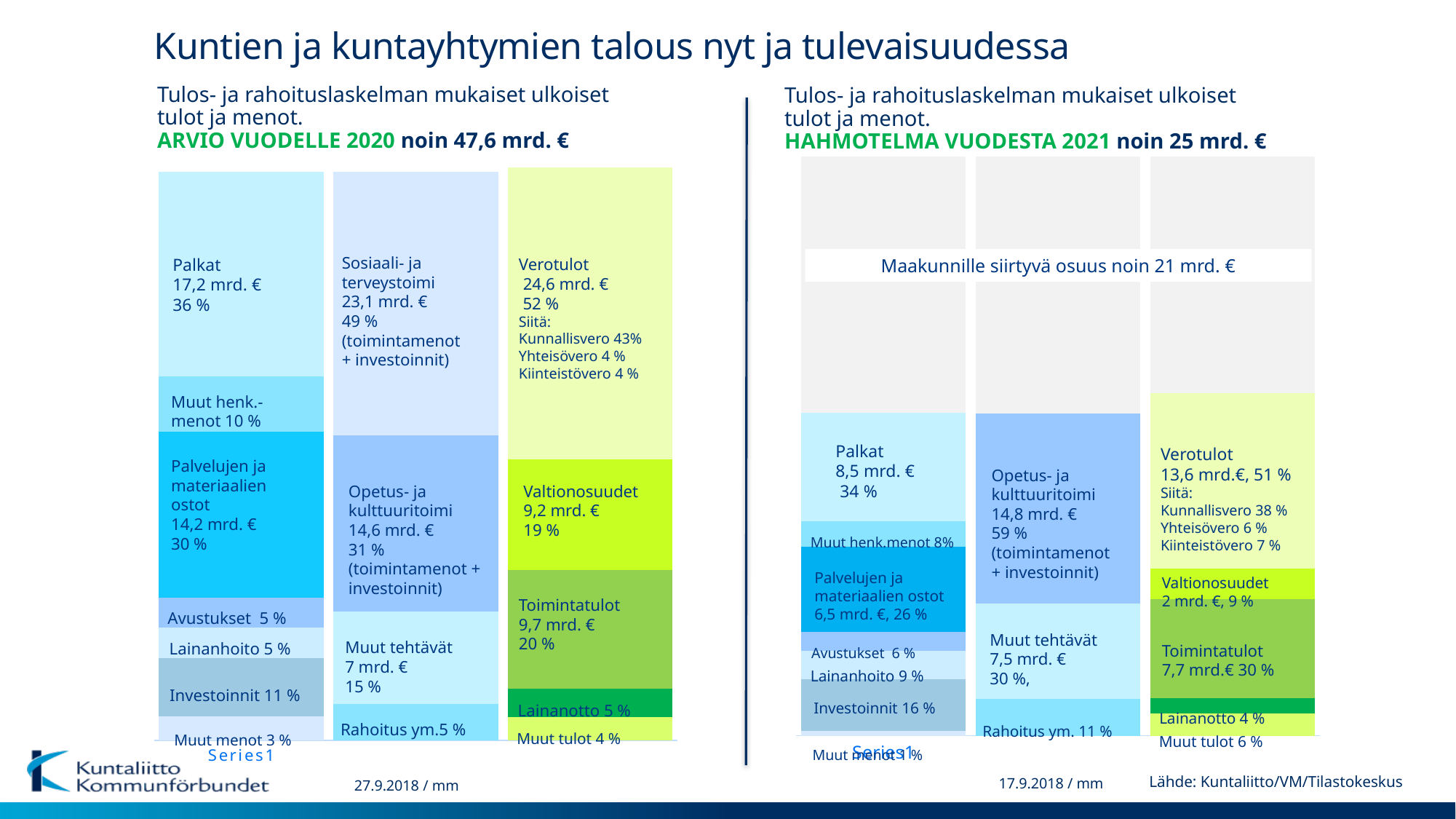
In the 2020 chart (ARVIO VUODELLE 2020), what value is shown for Palkat? 17,2 mrd. € According to the 2021 chart (HAHMOTELMA VUODESTA 2021), what is the total amount stated in its title? noin 25 mrd. € How many stacked bars does the 2021 chart (HAHMOTELMA VUODESTA 2021) contain? 3 What kind of chart is used on the left side of the slide (ARVIO VUODELLE 2020)? Stacked bar chart In the 2020 chart (ARVIO VUODELLE 2020), which segment of the first (expenditure) bar has the largest share? Palkat In the 2021 chart (HAHMOTELMA VUODESTA 2021), what percentage is shown for Investoinnit? 16 % In the 2020 chart (ARVIO VUODELLE 2020), what value in mrd. € is shown for Sosiaali- ja terveystoimi? 23,1 mrd. € In the 2021 chart (HAHMOTELMA VUODESTA 2021), what percentage is shown for Kunnallisvero within Verotulot? 38 % In the 2020 chart (ARVIO VUODELLE 2020), what percentage share is shown for Verotulot? 52 % In the 2020 chart (ARVIO VUODELLE 2020), which is larger: Valtionosuudet or Toimintatulot? Toimintatulot What is the difference in mrd. € between Palkat in the 2020 chart (17,2 mrd. €) and Palkat in the 2021 chart (8,5 mrd. €)? 8,7 mrd. € In the 2021 chart (HAHMOTELMA VUODESTA 2021), what value in mrd. € is shown for Opetus- ja kulttuuritoimi? 14,8 mrd. €